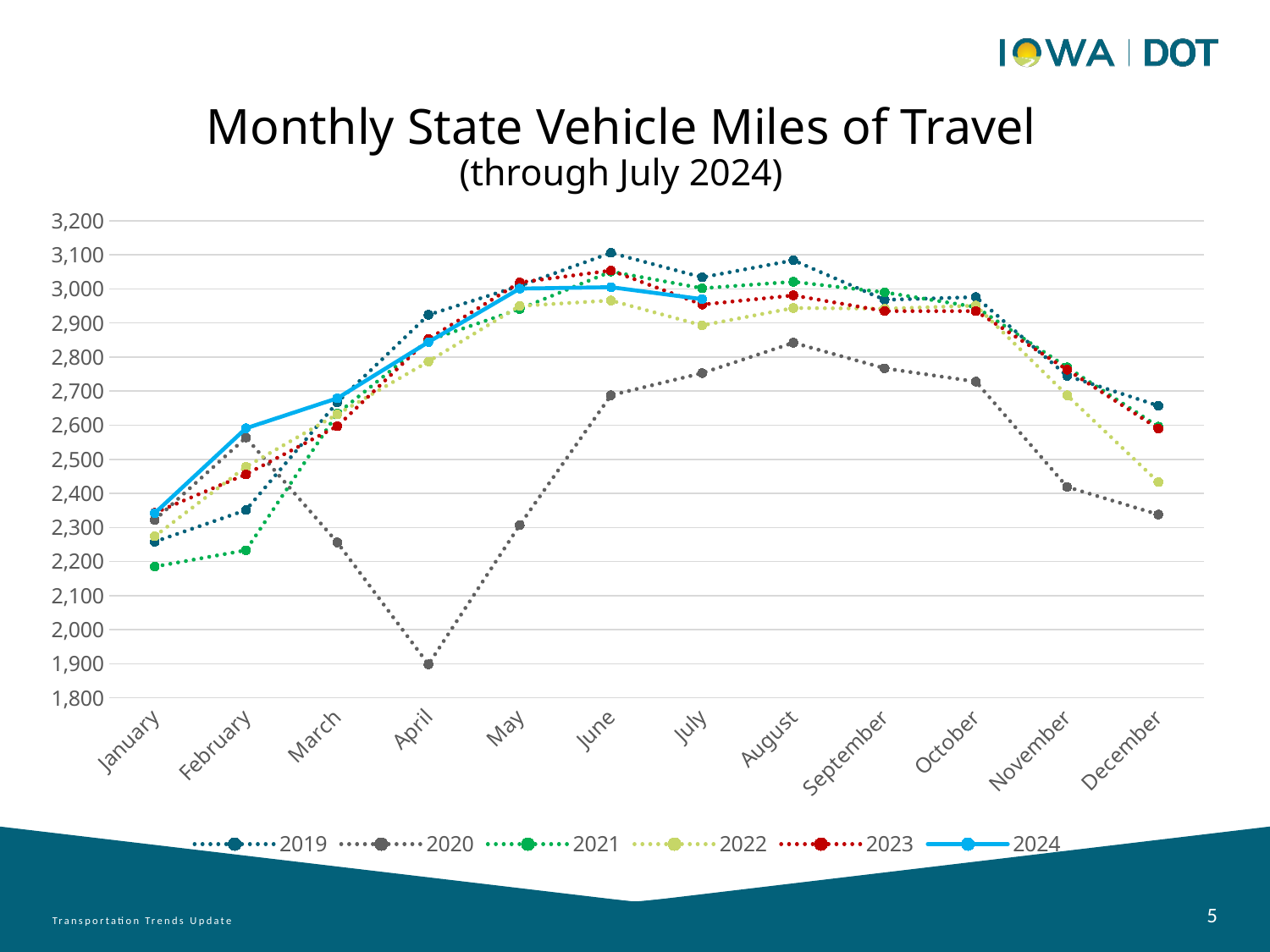
Which year has the lowest value in April? 2020 Is the 2020 value for April greater or less than 2,000? less In which month does the 2020 series reach its lowest value? April Which is larger in December, the 2022 value or the 2023 value? 2023 Which series is drawn as a solid line rather than a dotted line? 2024 Is the 2024 value for July greater or less than 3,000? less How many months are shown along the x axis? 12 How many series does the legend list? 6 Is the 2019 value for June greater or less than 3,000? greater Which year has the highest value in June? 2019 Does the 2024 series rise or fall from January to July? rise What kind of chart is shown on the slide? line chart